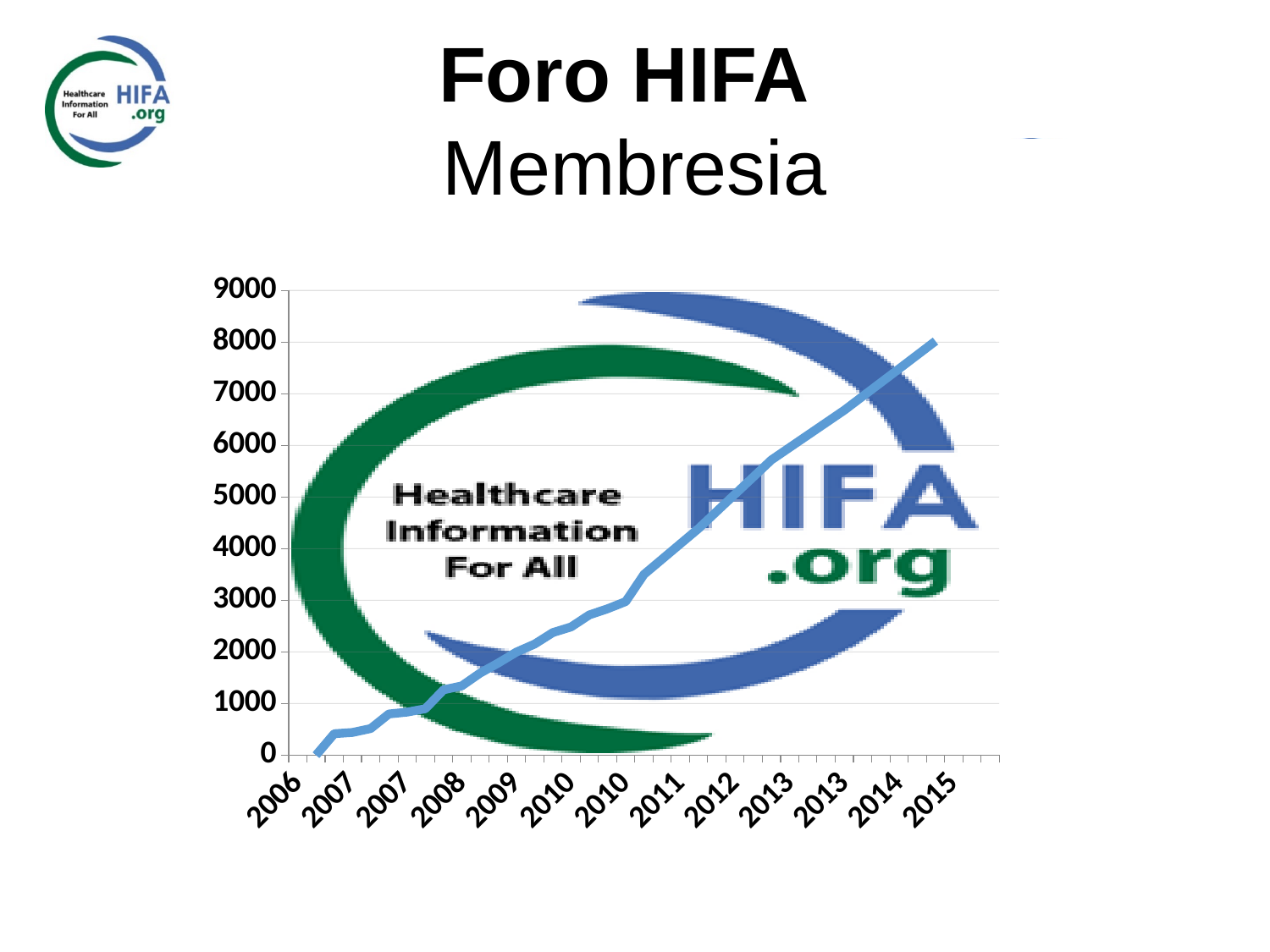
Which year label on the x axis has the highest value? 2015 Is the value for 2015 greater or less than 7000? greater Is the value for 2006 greater or less than 1000? less Is the value for 2011 greater or less than 3000? greater What kind of chart is shown on the slide? line chart Which year label on the x axis has the lowest value? 2006 How many labels are shown on the x axis? 13 What is the highest value shown on the y axis? 9000 Which year has the higher value, 2006 or 2015? 2015 Do the values rise or fall from 2006 to 2015? rise What colour is the plotted line? blue